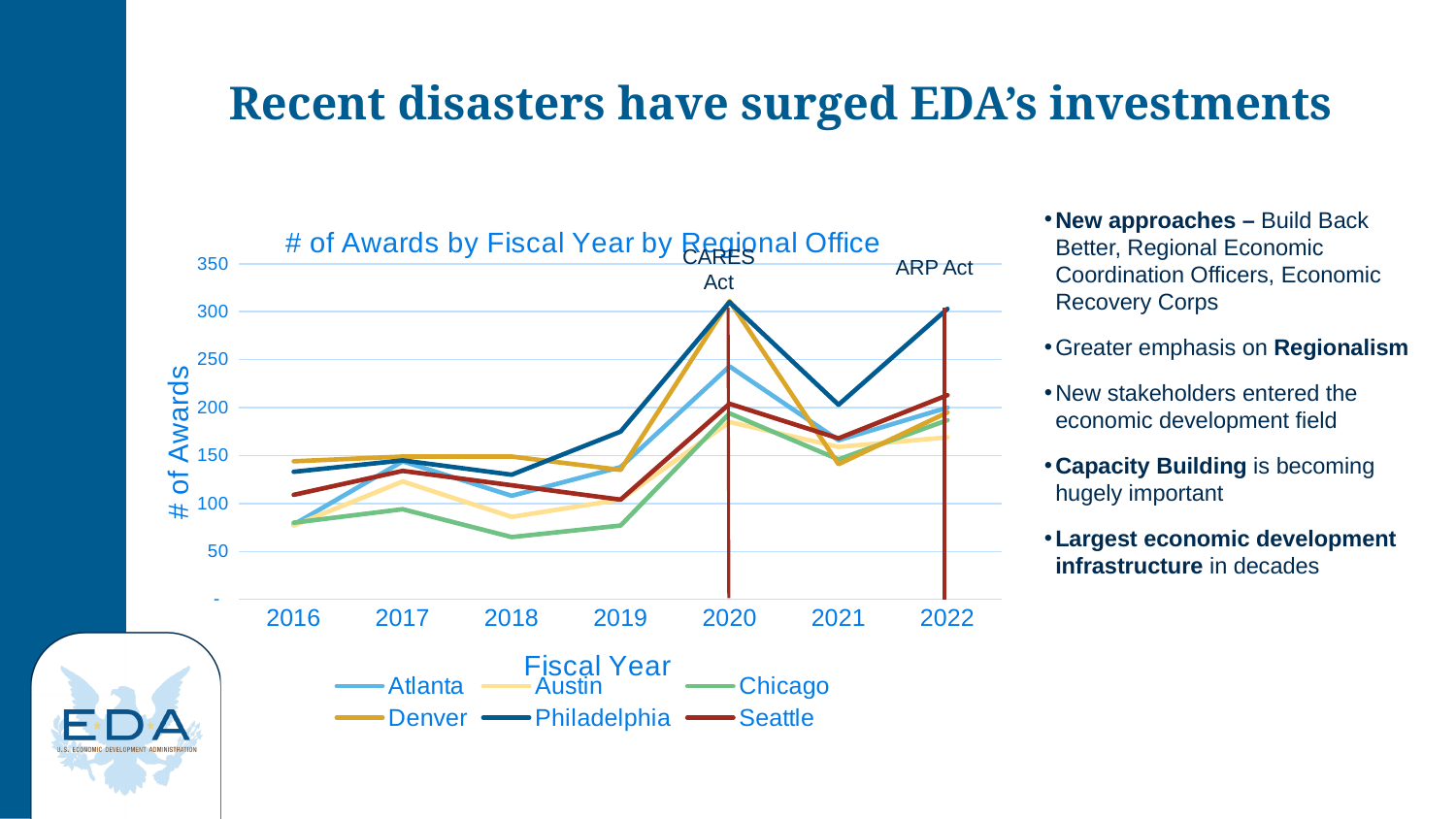
Is the value for Philadelphia in 2020 greater or less than 250? greater What kind of chart is shown on the slide? line chart In which fiscal year does Atlanta reach its highest number of awards? 2020 What is the title of the chart? # of Awards by Fiscal Year by Regional Office Is the value for Chicago in 2018 greater or less than 100? less How many series does the legend list? 6 Which regional office has the highest number of awards in 2022? Philadelphia How many fiscal years are plotted on the x axis? 7 Does the Philadelphia line rise or fall from 2016 to 2020? rise What is the label on the y axis of the chart? # of Awards Is the value for Atlanta in 2016 greater or less than 100? less Which regional office has the lowest number of awards in 2018? Chicago